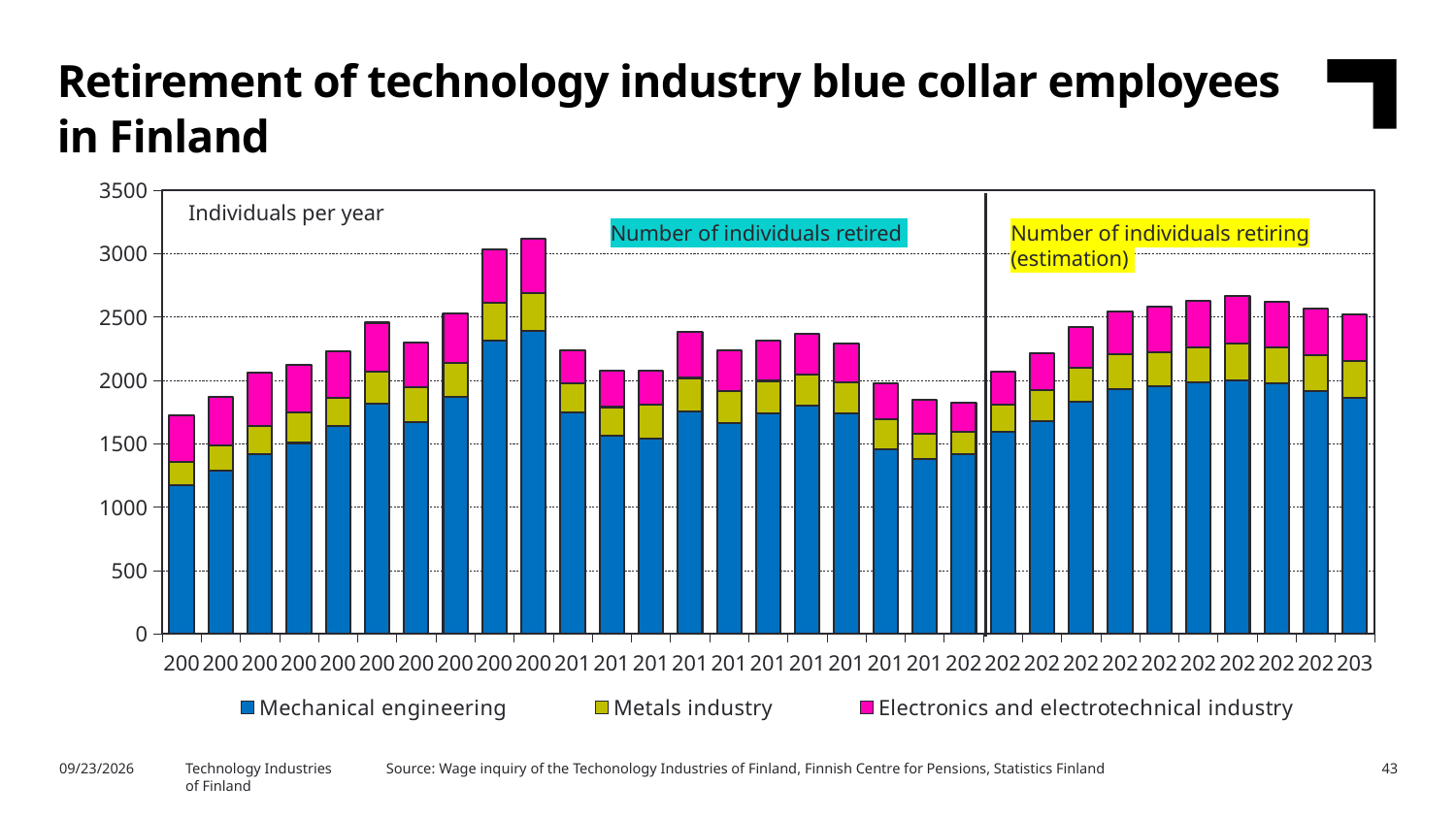
Is the tallest bar in the 'Number of individuals retired' section or the 'Number of individuals retiring (estimation)' section? Number of individuals retired From the first bar to the tenth bar, do the bar totals generally rise or fall? rise Is the total of the tallest bar greater or less than 3000? greater What label is written inside the top-left corner of the plot area? Individuals per year Is the total of the first (leftmost) bar greater or less than 2000? less How many series does the legend list? 3 Which series is shown in blue in the legend? Mechanical engineering What kind of chart is shown on the slide? Stacked bar chart Is the total of the last (rightmost) bar greater or less than 2000? greater Which is larger: the total of the tallest bar in the left (retired) section or the total of the tallest bar in the right (estimation) section? The tallest bar in the left (retired) section How many bars are plotted in the chart? 31